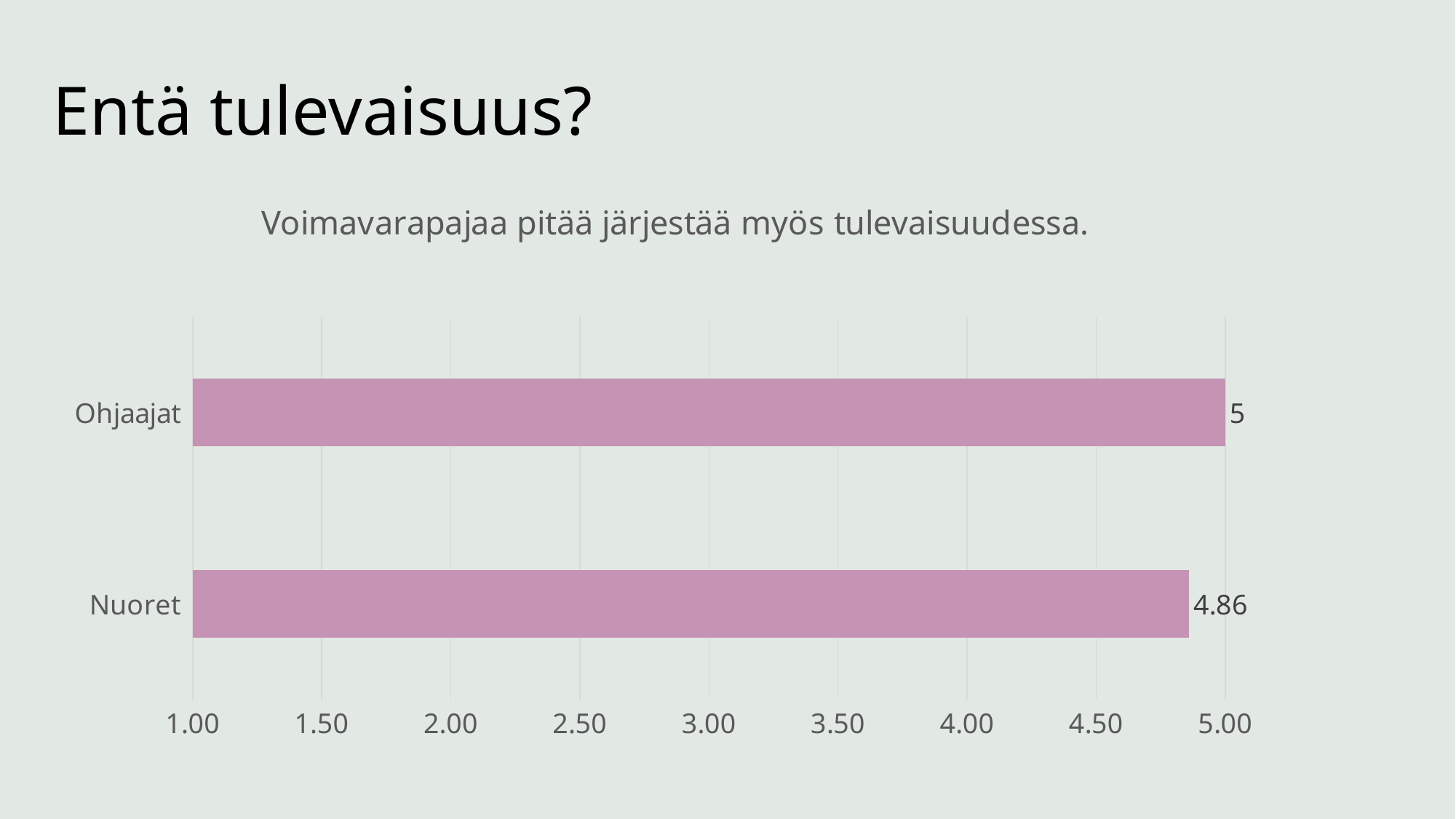
Which is larger, the value for Ohjaajat or the value for Nuoret? Ohjaajat What is the title of the chart? Voimavarapajaa pitää järjestää myös tulevaisuudessa. What kind of chart is shown on the slide? bar chart Is the value for Nuoret greater or less than 4.50? greater What is the value for Nuoret? 4.86 How many categories are shown in the chart? 2 What is the difference between the values for Ohjaajat and Nuoret? 0.14 What is the value for Ohjaajat? 5 Which category has the lowest value? Nuoret What is the highest value shown on the x axis? 5.00 Which category has the highest value? Ohjaajat